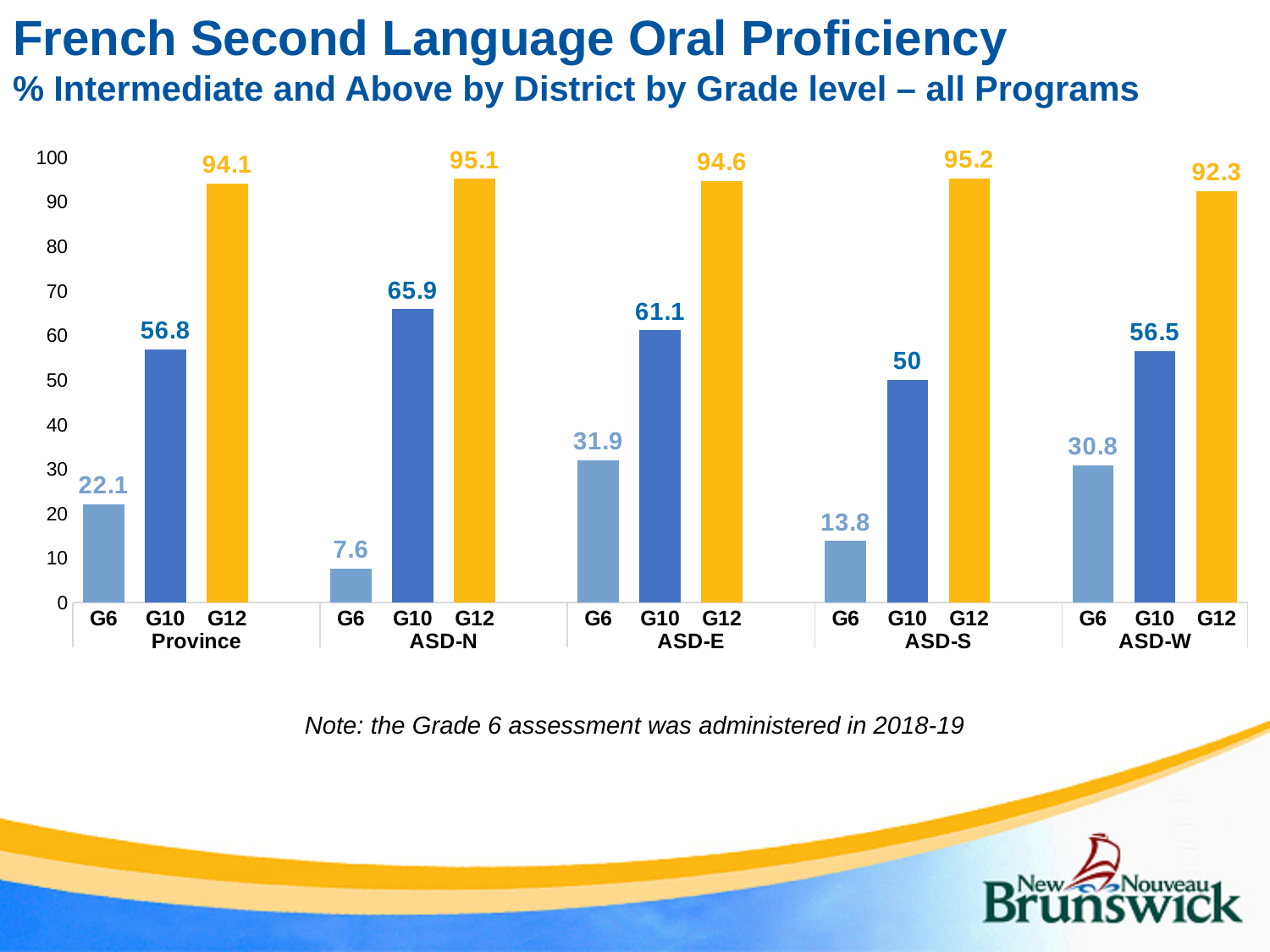
What is the difference between the G12 and G6 values for the Province? 72 Is the G6 value for ASD-S greater or less than 20? less Which district has the highest G6 value? ASD-E What colour are the G12 bars? yellow What is the G6 value for ASD-N? 7.6 How many districts (groups) are shown on the x axis? 5 Which is larger, the G10 value for ASD-N or the G10 value for ASD-W? ASD-N What is the G12 value for ASD-S? 95.2 What kind of chart is shown on the slide? bar chart What is the G10 value for ASD-E? 61.1 Within each district, do the values rise or fall from G6 to G12? rise Which district has the lowest G12 value? ASD-W